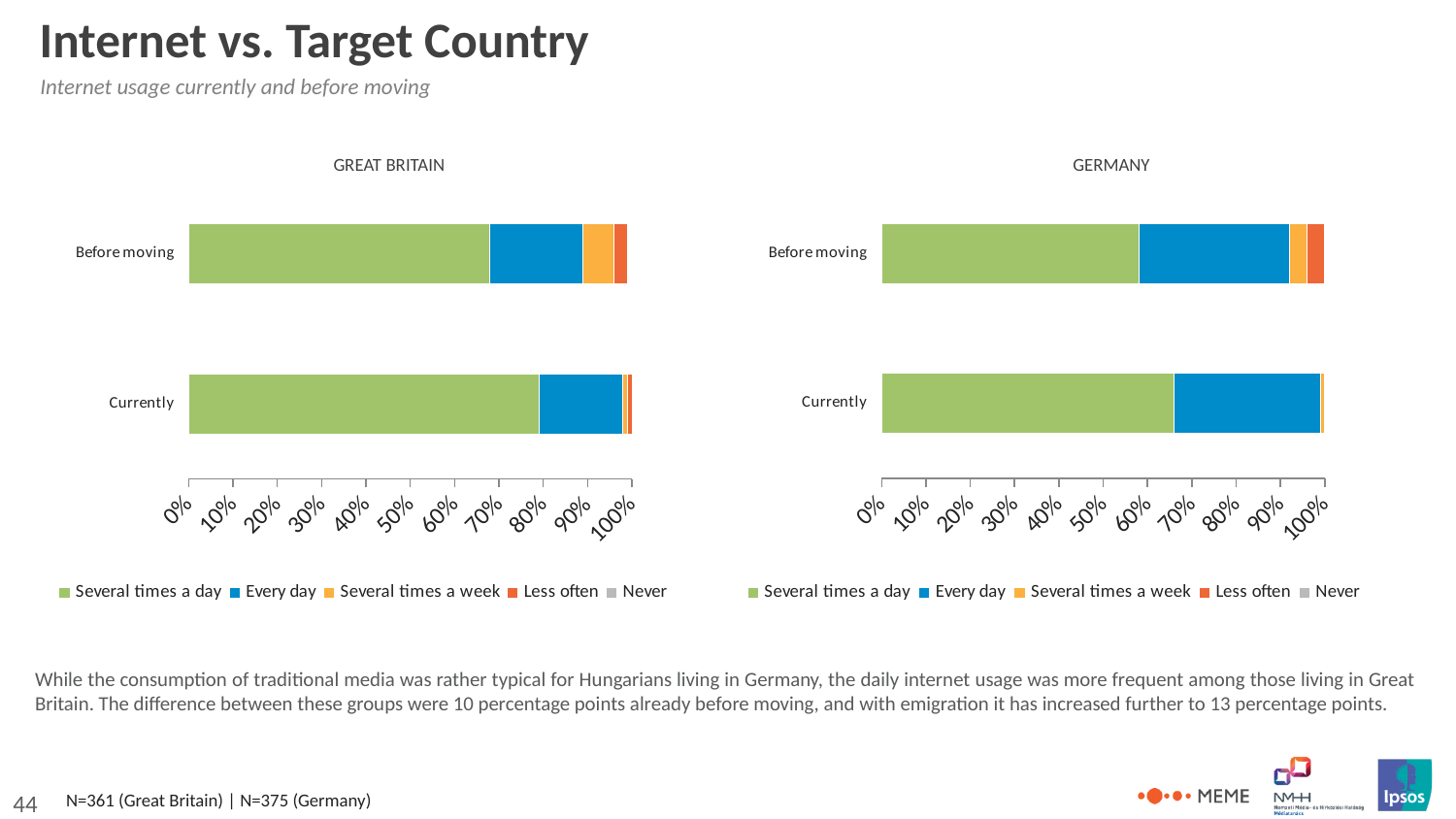
What are the names of the two charts on the slide? Great Britain and Germany In the Great Britain chart, is the 'Several times a day' value for 'Before moving' greater or less than 60%? greater How many categories are shown on the Great Britain chart? 2 In the Germany chart, is the 'Several times a day' value for 'Currently' greater or less than 60%? greater In the Great Britain chart, which category has the larger 'Several times a day' segment, 'Before moving' or 'Currently'? Currently What kind of chart is used for the Great Britain chart? Stacked bar chart How many series does the legend of the Germany chart list? 5 Which legend entry is shown in green on the Great Britain chart? Several times a day In the Germany chart, is the 'Several times a day' value for 'Before moving' greater or less than 50%? greater In the Germany chart, which category has the larger 'Several times a week' segment, 'Before moving' or 'Currently'? Before moving In the Germany chart, which category has the larger 'Several times a day' segment, 'Before moving' or 'Currently'? Currently